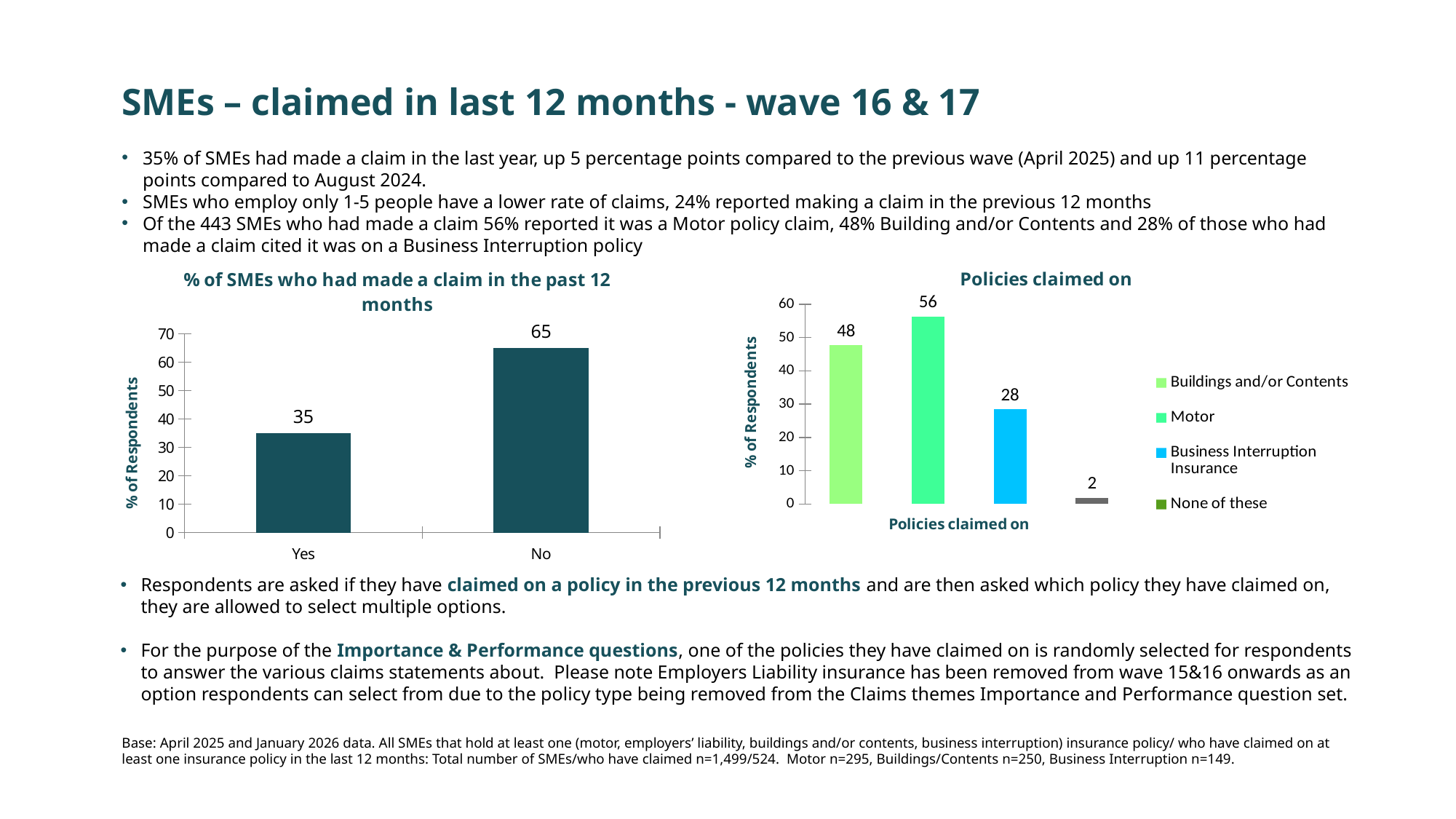
In the '% of SMEs who had made a claim in the past 12 months' chart, how many categories are shown on the x axis? 2 In the 'Policies claimed on' chart, which policy has the lowest value? None of these In the 'Policies claimed on' chart, what is the label on the vertical axis? % of Respondents In the 'Policies claimed on' chart, how many entries does the legend list? 4 In the 'Policies claimed on' chart, what is the value for Motor? 56 In the '% of SMEs who had made a claim in the past 12 months' chart, what is the value for No? 65 In the 'Policies claimed on' chart, what is the value for Business Interruption Insurance? 28 In the '% of SMEs who had made a claim in the past 12 months' chart, what is the value for Yes? 35 In the '% of SMEs who had made a claim in the past 12 months' chart, what is the difference between the No and Yes values? 30 In the 'Policies claimed on' chart, which policy has the highest value? Motor In the 'Policies claimed on' chart, what is the difference between the Motor and Buildings and/or Contents values? 8 What kind of chart is the '% of SMEs who had made a claim in the past 12 months' chart? Bar chart